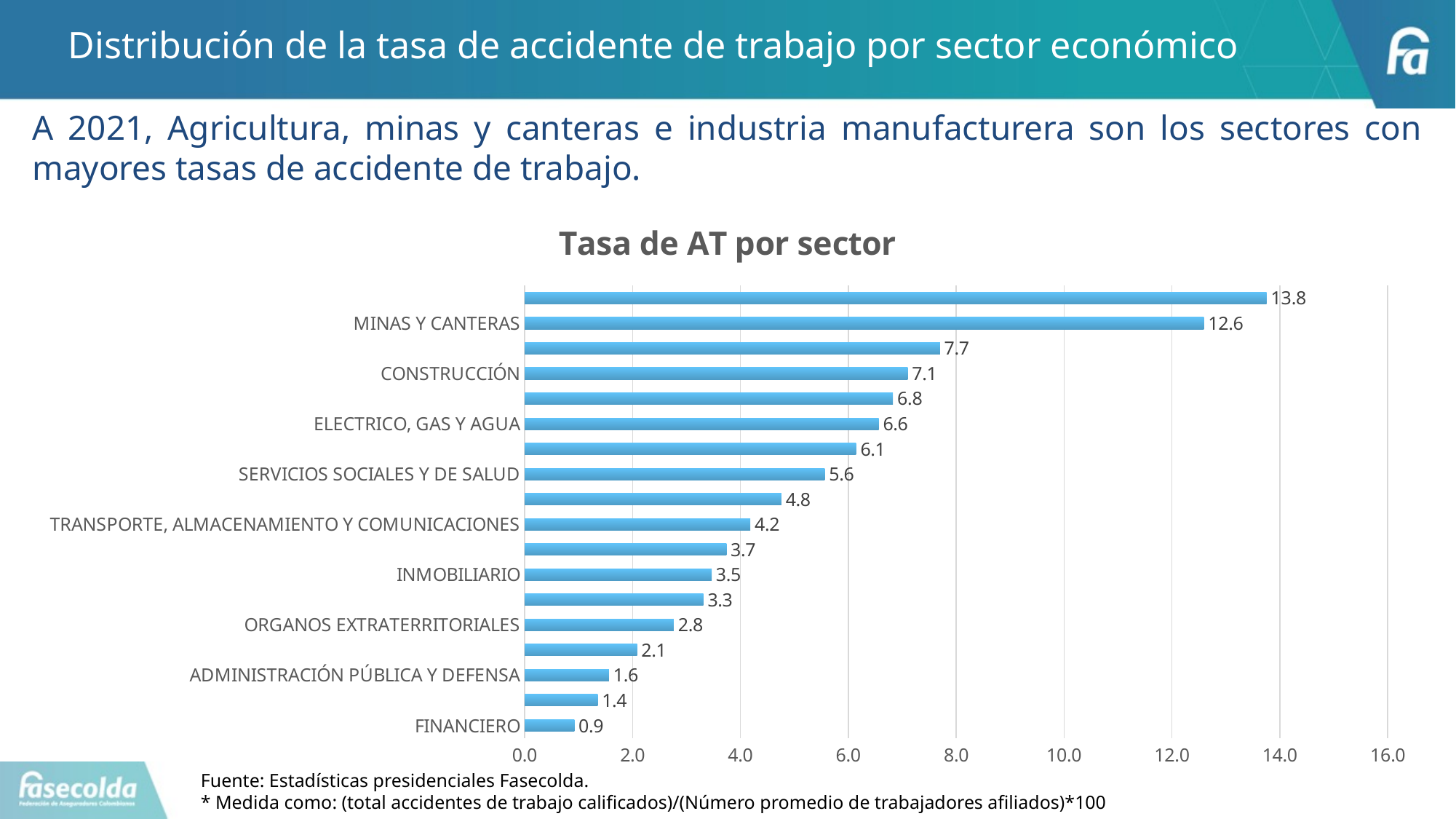
What is the difference between the values for TRANSPORTE, ALMACENAMIENTO Y COMUNICACIONES and ORGANOS EXTRATERRITORIALES? 1.4 What is the title of the chart on the slide? Tasa de AT por sector What is the value for INMOBILIARIO in the chart? 3.5 What is the value for MINAS Y CANTERAS in the Tasa de AT por sector chart? 12.6 What is the difference between the values for MINAS Y CANTERAS and CONSTRUCCIÓN? 5.5 Is the value for ORGANOS EXTRATERRITORIALES greater or less than 4.0? less What kind of chart is shown on the slide? bar chart What is the value for CONSTRUCCIÓN in the chart? 7.1 Which is larger, the value for ELECTRICO, GAS Y AGUA or the value for SERVICIOS SOCIALES Y DE SALUD? ELECTRICO, GAS Y AGUA Which labeled sector has the lowest value in the chart? FINANCIERO What is the value for FINANCIERO in the chart? 0.9 What is the value for ADMINISTRACIÓN PÚBLICA Y DEFENSA in the chart? 1.6